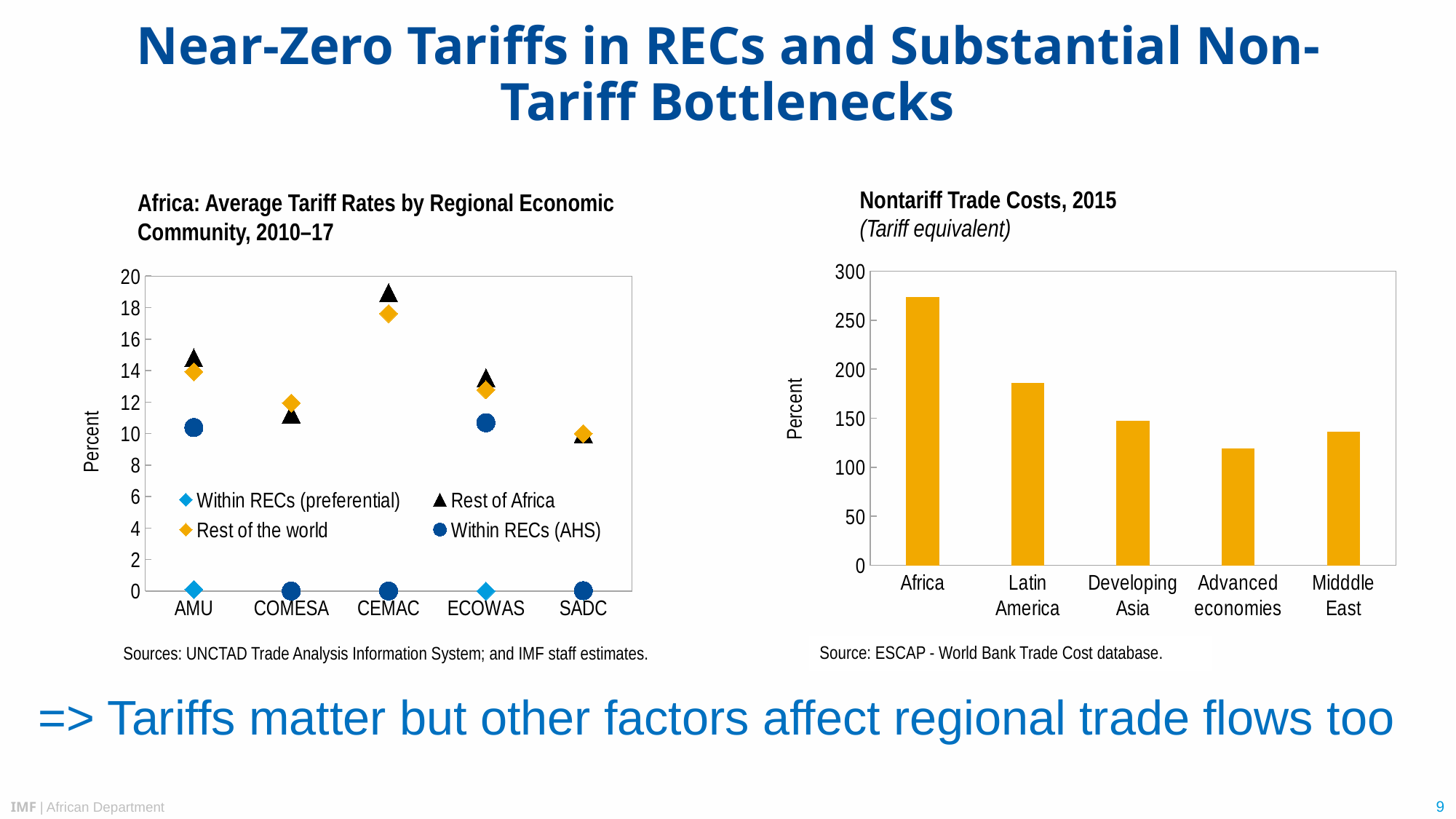
In the 'Nontariff Trade Costs, 2015' chart, is the value for Advanced economies greater or less than 100? greater In the 'Nontariff Trade Costs, 2015' chart, is the value for Latin America greater or less than 200? less What kind of chart is the 'Nontariff Trade Costs, 2015' chart? bar chart In the 'Africa: Average Tariff Rates by Regional Economic Community, 2010–17' chart, is the 'Rest of Africa' value for CEMAC greater or less than 18? greater In the 'Africa: Average Tariff Rates by Regional Economic Community, 2010–17' chart, what is the label of the y axis? Percent In the 'Africa: Average Tariff Rates by Regional Economic Community, 2010–17' chart, which regional economic community has the highest 'Rest of the world' value? CEMAC How many regions are shown in the 'Nontariff Trade Costs, 2015' chart? 5 In the 'Nontariff Trade Costs, 2015' chart, which region has the highest value? Africa How many series does the legend list in the 'Africa: Average Tariff Rates by Regional Economic Community, 2010–17' chart? 4 In the 'Nontariff Trade Costs, 2015' chart, which is larger, the value for Developing Asia or the value for Middle East? Developing Asia In the 'Nontariff Trade Costs, 2015' chart, which region has the lowest value? Advanced economies